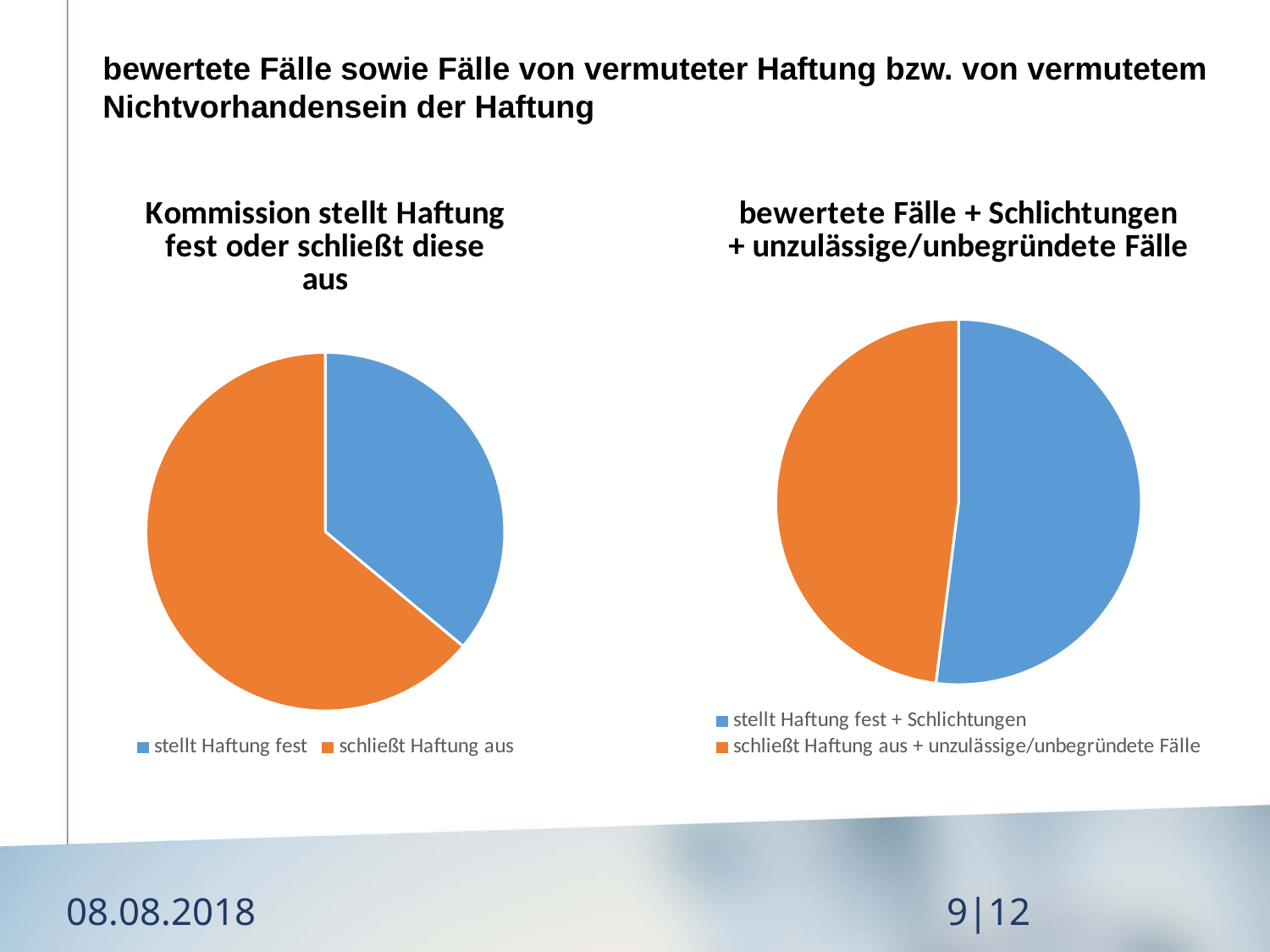
What kind of chart is the left chart titled "Kommission stellt Haftung fest oder schließt diese aus"? Pie chart In the right chart "bewertete Fälle + Schlichtungen + unzulässige/unbegründete Fälle", which category is shown in orange? schließt Haftung aus + unzulässige/unbegründete Fälle In the right chart "bewertete Fälle + Schlichtungen + unzulässige/unbegründete Fälle", how many slices does the pie have? 2 In the left chart "Kommission stellt Haftung fest oder schließt diese aus", which category is shown in blue? stellt Haftung fest How many entries does the legend of the left chart "Kommission stellt Haftung fest oder schließt diese aus" list? 2 In the left chart "Kommission stellt Haftung fest oder schließt diese aus", which category has the largest slice? schließt Haftung aus In the left chart "Kommission stellt Haftung fest oder schließt diese aus", which category has the smallest slice? stellt Haftung fest What kind of chart is the right chart titled "bewertete Fälle + Schlichtungen + unzulässige/unbegründete Fälle"? Pie chart In the left chart "Kommission stellt Haftung fest oder schließt diese aus", which slice is larger: "stellt Haftung fest" or "schließt Haftung aus"? schließt Haftung aus In the left chart "Kommission stellt Haftung fest oder schließt diese aus", how many slices does the pie have? 2 How many entries does the legend of the right chart "bewertete Fälle + Schlichtungen + unzulässige/unbegründete Fälle" list? 2